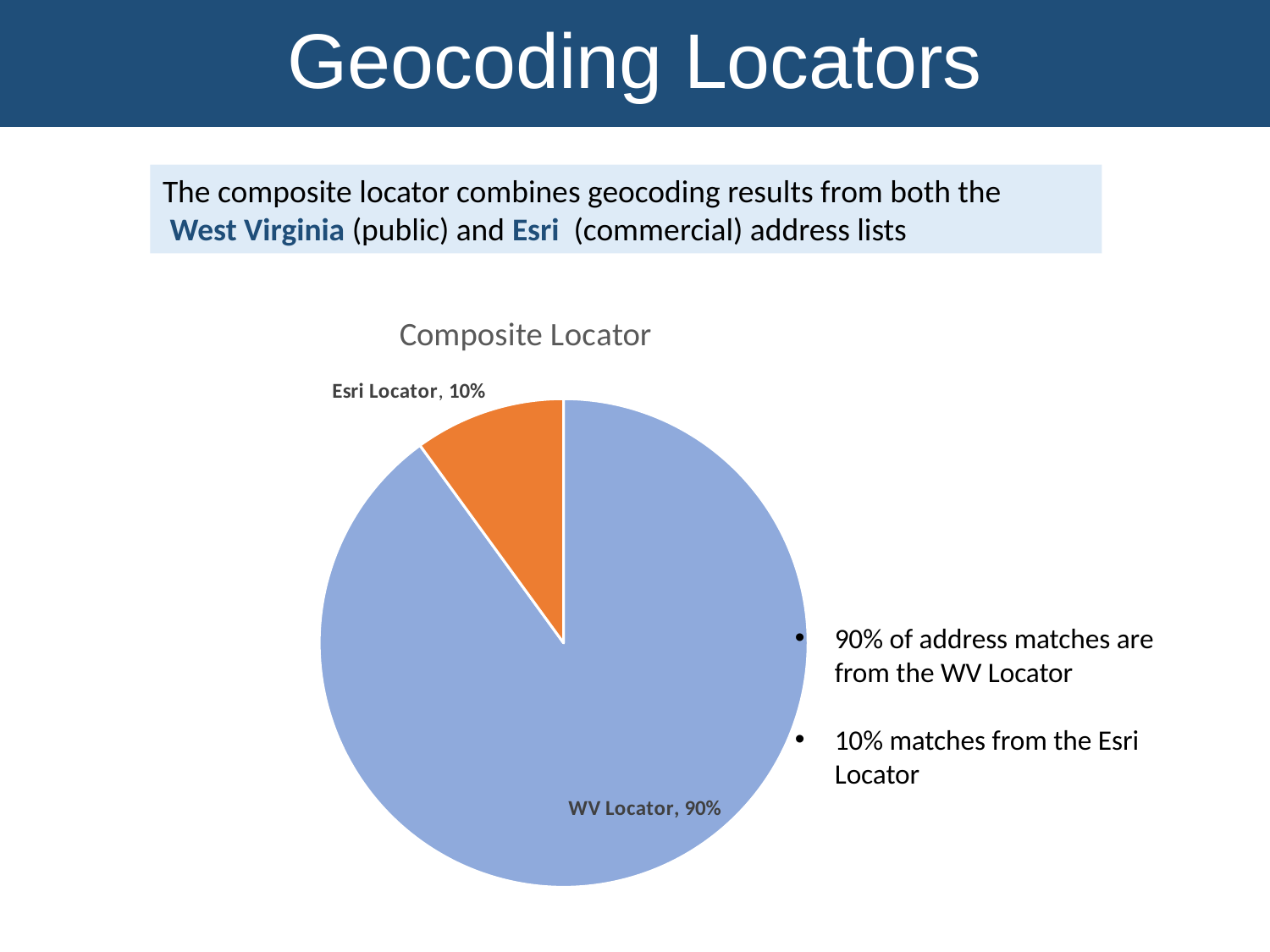
How many slices does the pie chart have? 2 What colour is the Esri Locator slice? orange Which slice of the pie is the smallest? Esri Locator What type of chart is shown on the slide? pie chart What is the total of the two slices shown in the pie chart? 100% What share of the pie does the WV Locator slice represent? 90% Which is larger, the WV Locator slice or the Esri Locator slice? WV Locator What share of the pie does the Esri Locator slice represent? 10% What is the title of the chart? Composite Locator Which slice of the pie is the largest? WV Locator What is the difference in percentage points between the WV Locator and Esri Locator slices? 80%